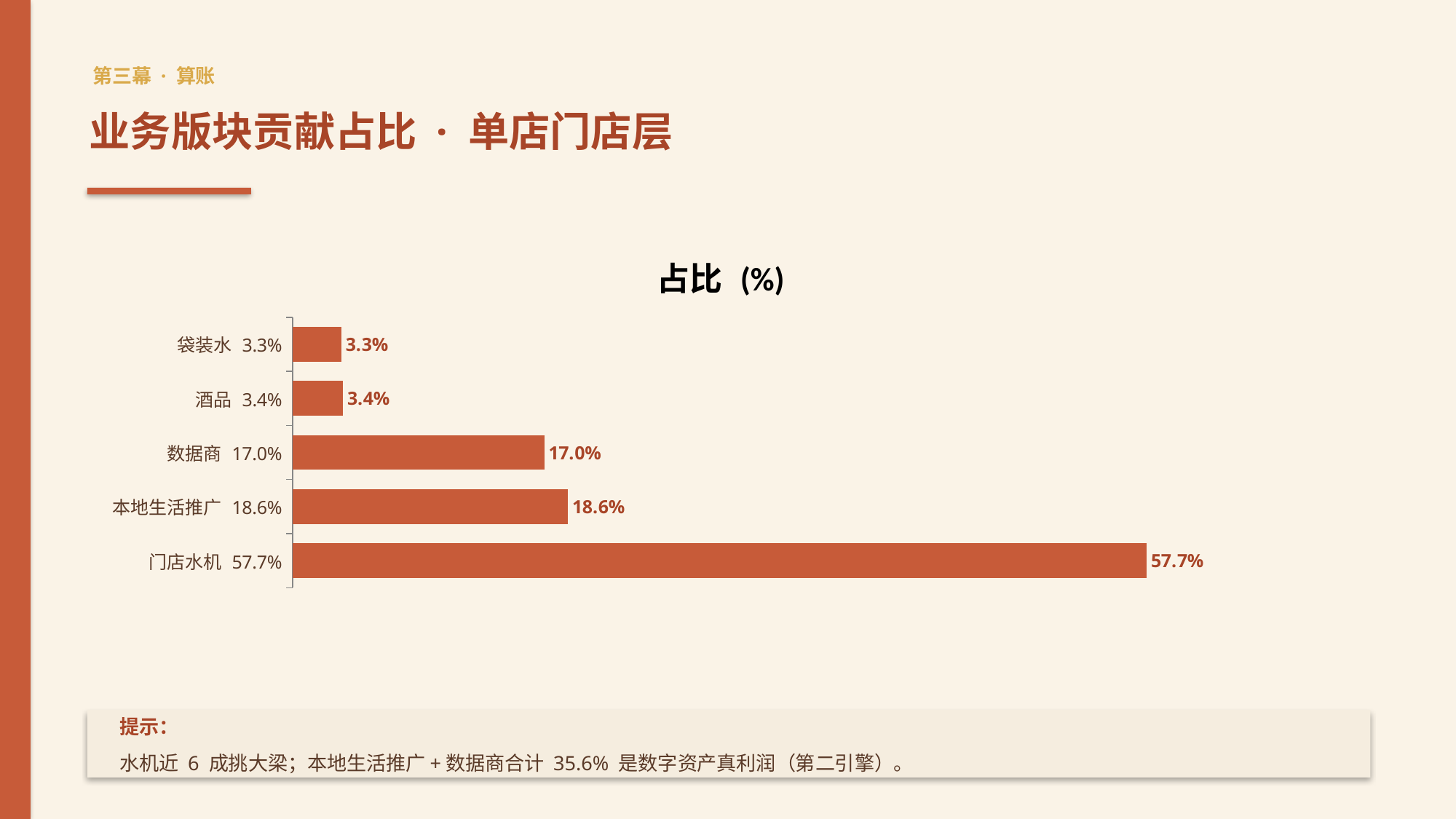
What is the value for 数据商? 17.0% Which category has the highest value? 门店水机 Which category has the lowest value? 袋装水 What is the value for 本地生活推广? 18.6% What is the value for 袋装水? 3.3% What kind of chart is shown on the slide? bar chart How many categories are shown in the chart? 5 What is the difference between the values for 门店水机 and 本地生活推广? 39.1% Which is larger, the value for 数据商 or the value for 本地生活推广? 本地生活推广 What is the title of the chart? 占比 (%) What is the value for 门店水机? 57.7% What is the difference between the values for 本地生活推广 and 数据商? 1.6%